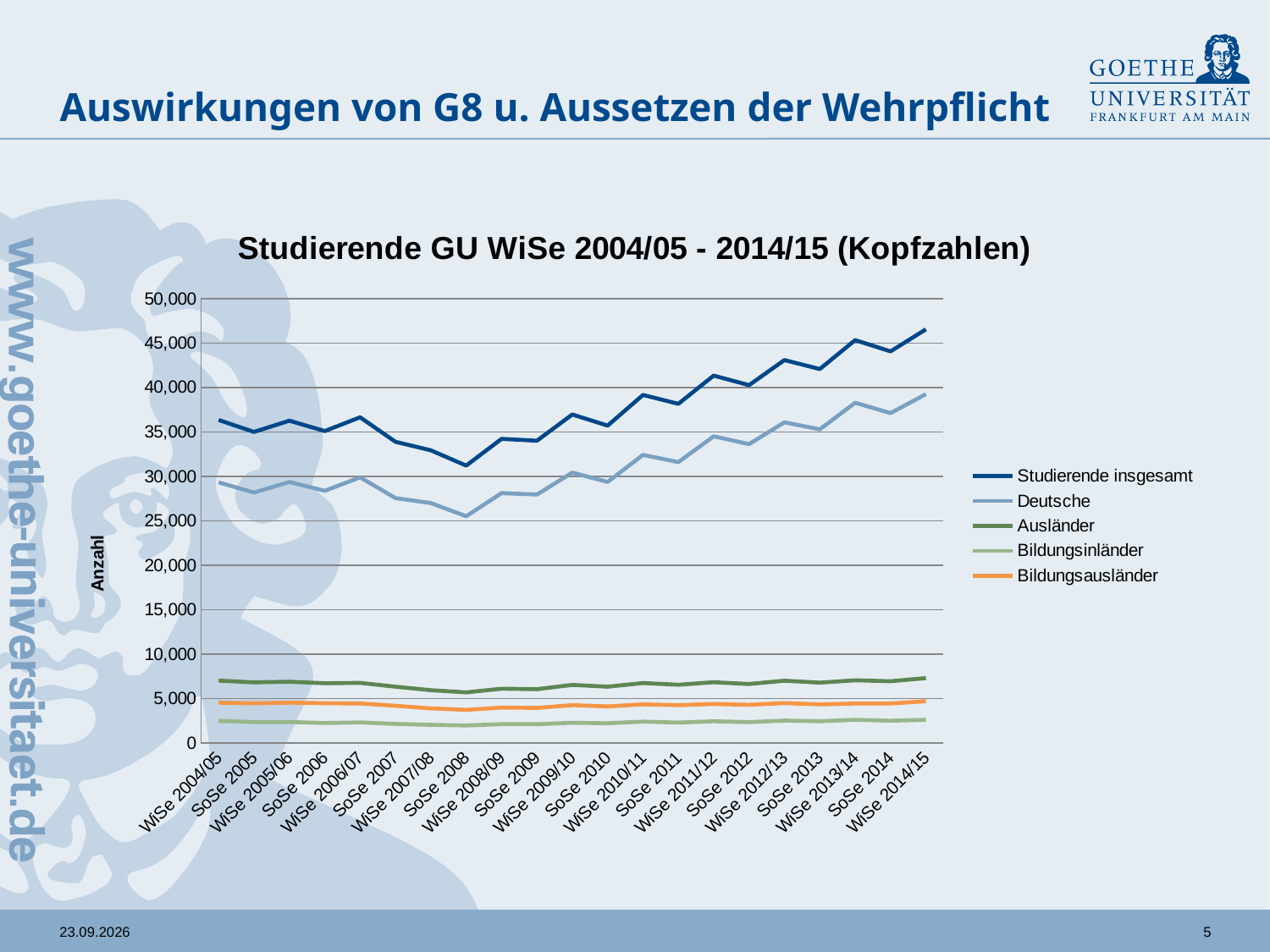
What kind of chart is shown on the slide? line chart Is the value for Studierende insgesamt in WiSe 2014/15 greater or less than 45,000? greater In which semester does the Studierende insgesamt series reach its lowest value? SoSe 2008 What is the title of the chart? Studierende GU WiSe 2004/05 - 2014/15 (Kopfzahlen) What is the label of the vertical axis? Anzahl Is the value for Deutsche in SoSe 2008 greater or less than 30,000? less Does the Studierende insgesamt series rise or fall overall from WiSe 2004/05 to WiSe 2014/15? rise Which series has the lowest values throughout the chart? Bildungsinländer How many semesters (points) are shown along the x axis? 21 How many series does the legend list? 5 In which semester does the Studierende insgesamt series reach its highest value? WiSe 2014/15 Which is larger in WiSe 2014/15, Ausländer or Bildungsausländer? Ausländer